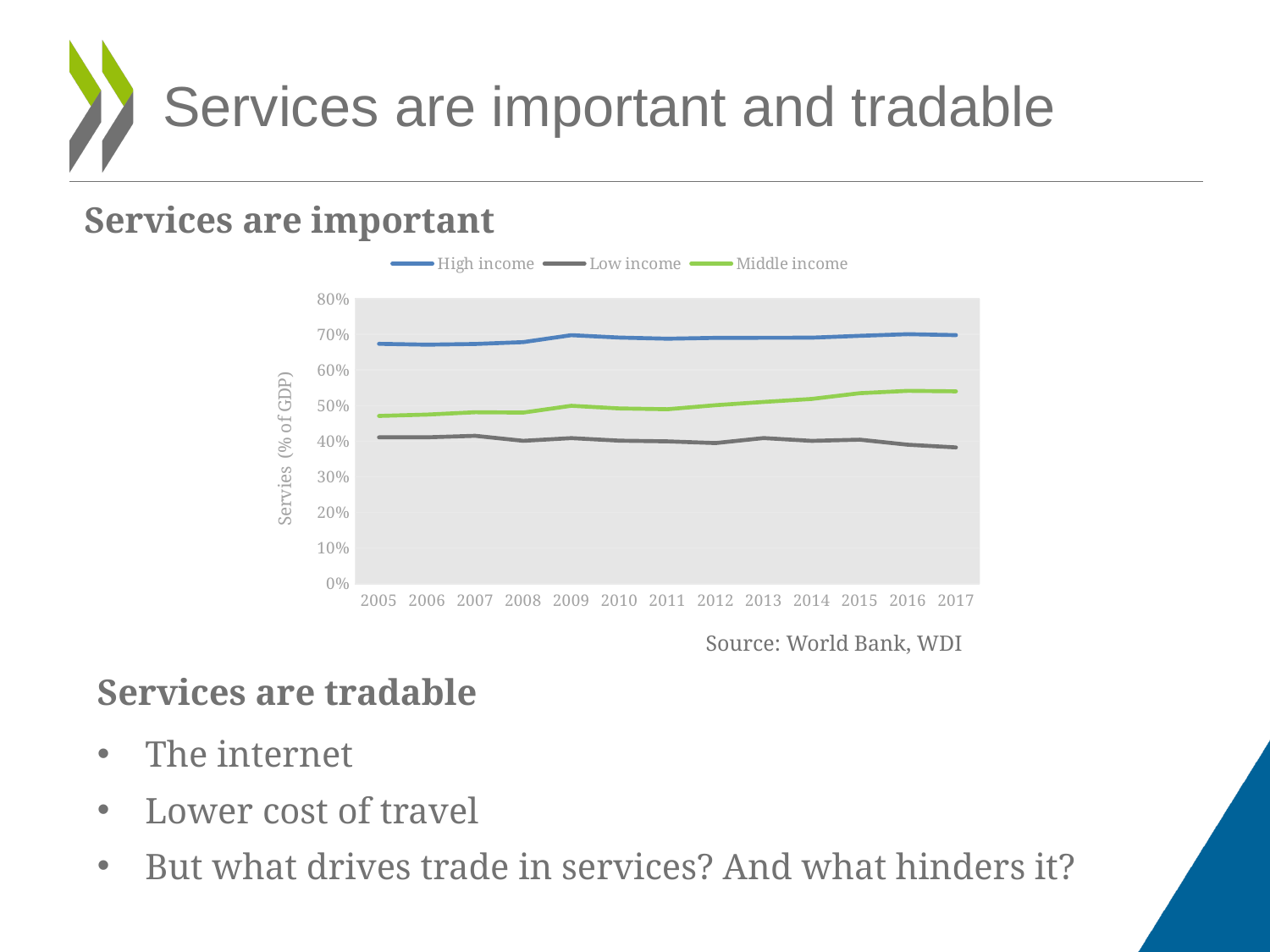
How many years are shown along the x axis of the chart? 13 What is the source cited below the chart? World Bank, WDI Does the Middle income line rise or fall from 2005 to 2017? Rise Is the value for High income in 2017 greater or less than 60%? greater In 2010, which is larger: the value for High income or the value for Middle income? High income Is the value for Middle income in 2005 greater or less than 50%? less Which series has the highest values throughout the chart? High income Is the value for Middle income in 2017 greater or less than 50%? greater How many series does the chart legend list? 3 What kind of chart is shown on the slide? Line chart Which series has the lowest values throughout the chart? Low income